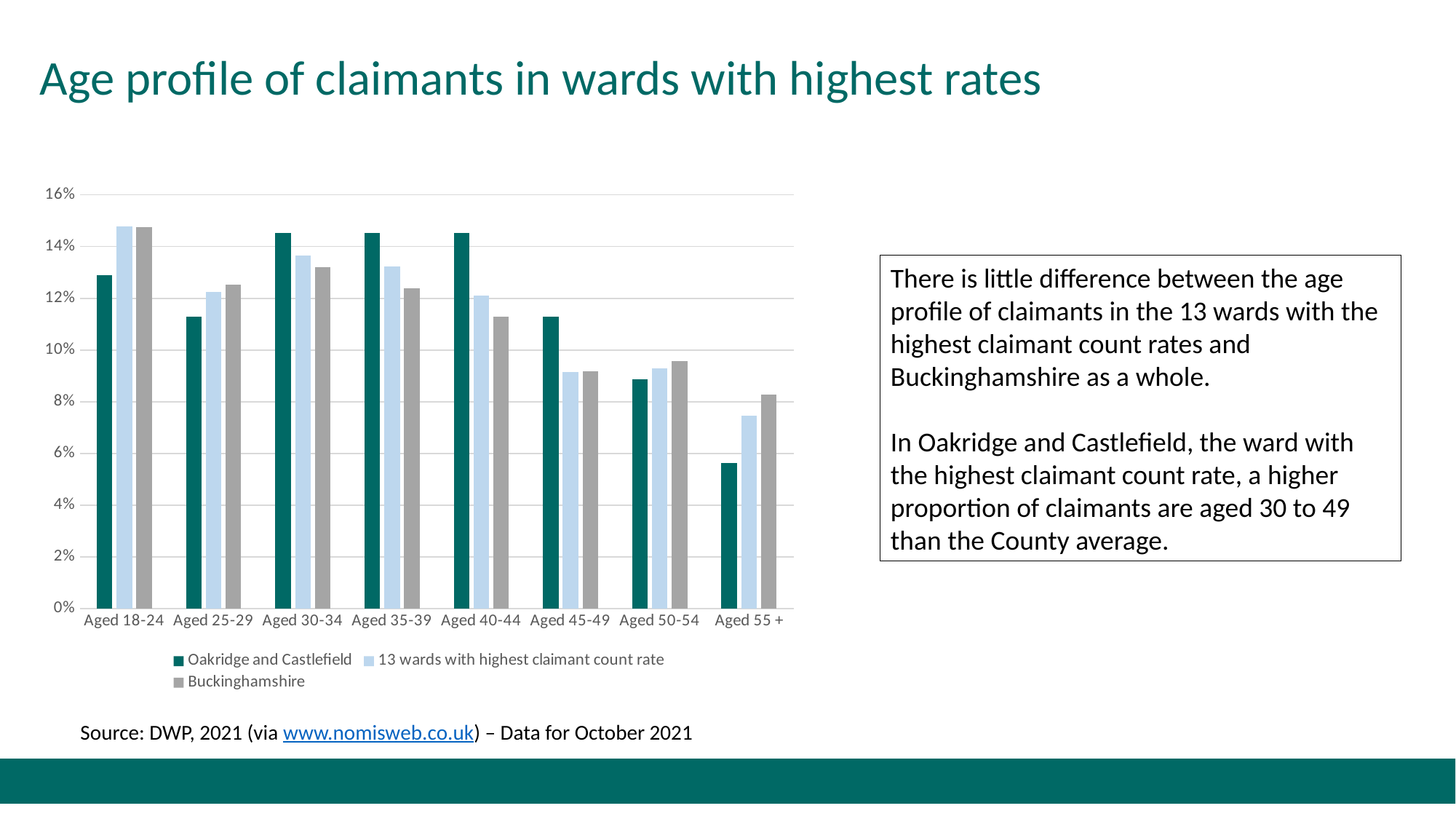
For Aged 40-44, which is larger: Oakridge and Castlefield or Buckinghamshire? Oakridge and Castlefield For which age category is the Buckinghamshire value highest? Aged 18-24 For which age category is the Oakridge and Castlefield value lowest? Aged 55 + Is the Oakridge and Castlefield value for Aged 55 + greater or less than 6%? less Is the 13 wards with highest claimant count rate value for Aged 55 + greater or less than 8%? less How many series does the legend list? 3 What is the title of the chart slide? Age profile of claimants in wards with highest rates Do the Oakridge and Castlefield values rise or fall from Aged 40-44 to Aged 55 +? fall For Aged 55 +, which is larger: Oakridge and Castlefield or Buckinghamshire? Buckinghamshire What kind of chart is shown on the slide? Bar chart How many age categories are shown on the x axis? 8 Is the Buckinghamshire value for Aged 18-24 greater or less than 14%? greater